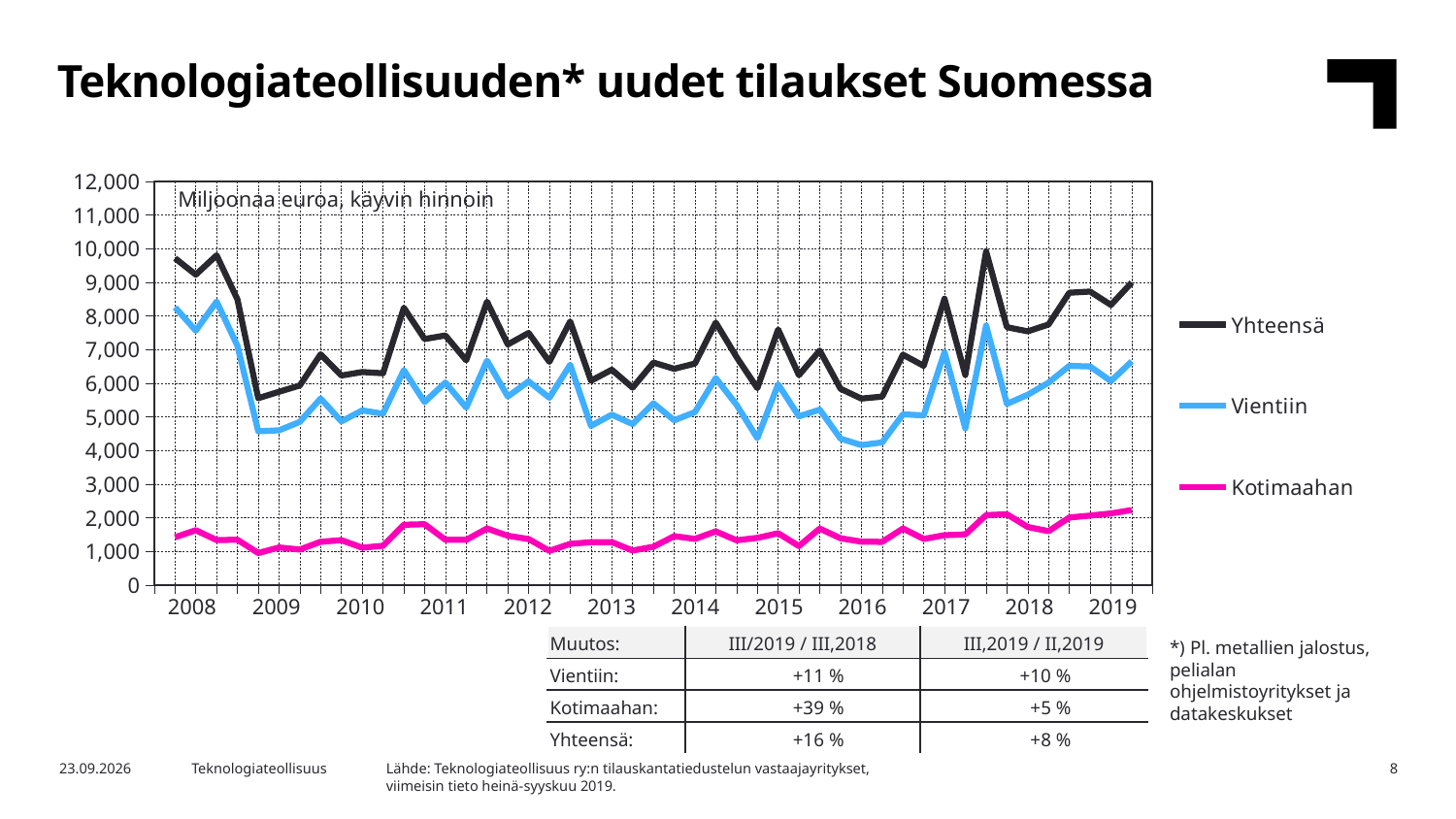
Does the Kotimaahan line rise or fall from 2016 to 2019? Rise Is the value for Kotimaahan in 2019 greater or less than 3,000? less How many year labels are shown on the x axis? 12 What unit is stated inside the chart area? Miljoonaa euroa, käyvin hinnoin How many series does the chart legend list? 3 What kind of chart is shown on the slide? Line chart Which series has the lowest values throughout the chart? Kotimaahan Which series is larger in 2019, Vientiin or Kotimaahan? Vientiin Which series has the highest values throughout the chart? Yhteensä Is the value for Yhteensä at the start of 2008 greater or less than 9,000? greater Does the Yhteensä line rise or fall from 2008 to 2009? Fall